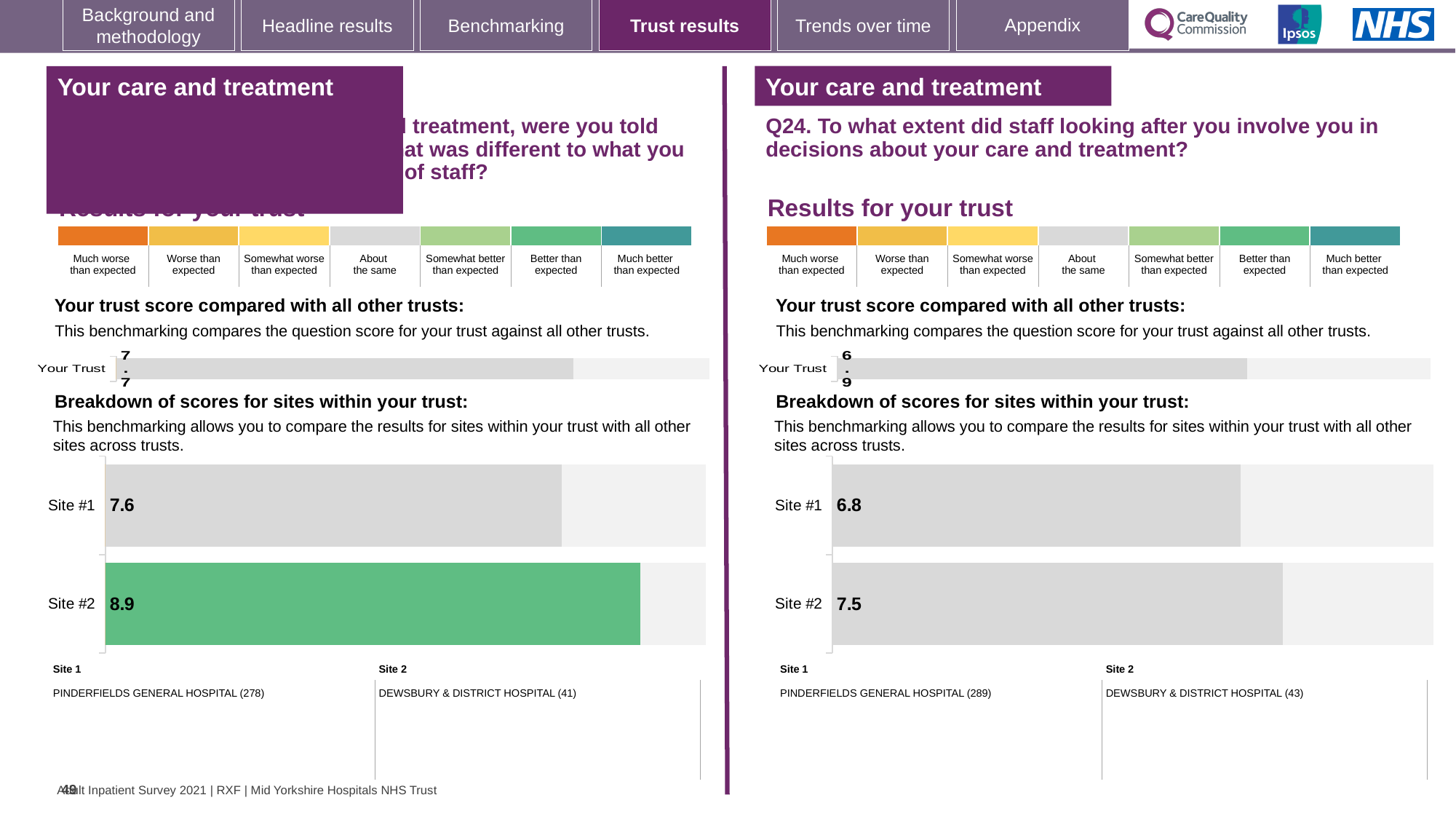
In the right-hand (Q24) site breakdown chart, what is the score for Site #2? 7.5 In the left-hand site breakdown chart, which site has the higher score? Site #2 In the left-hand 'Your trust score compared with all other trusts' chart, what is the score for Your Trust? 7.7 In the right-hand (Q24) site breakdown chart, which site has the lower score? Site #1 In the left-hand site breakdown chart, what is the difference between the Site #2 and Site #1 scores? 1.3 In the right-hand (Q24) 'Your trust score compared with all other trusts' chart, what is the score for Your Trust? 6.9 In the right-hand (Q24) site breakdown chart, what is the difference between the Site #2 and Site #1 scores? 0.7 How many sites are shown in the right-hand (Q24) site breakdown chart? 2 What kind of chart is the left-hand site breakdown chart? Bar chart In the right-hand (Q24) site breakdown chart, what is the score for Site #1? 6.8 In the left-hand site breakdown chart, what is the score for Site #1? 7.6 In the left-hand site breakdown chart, what is the score for Site #2? 8.9